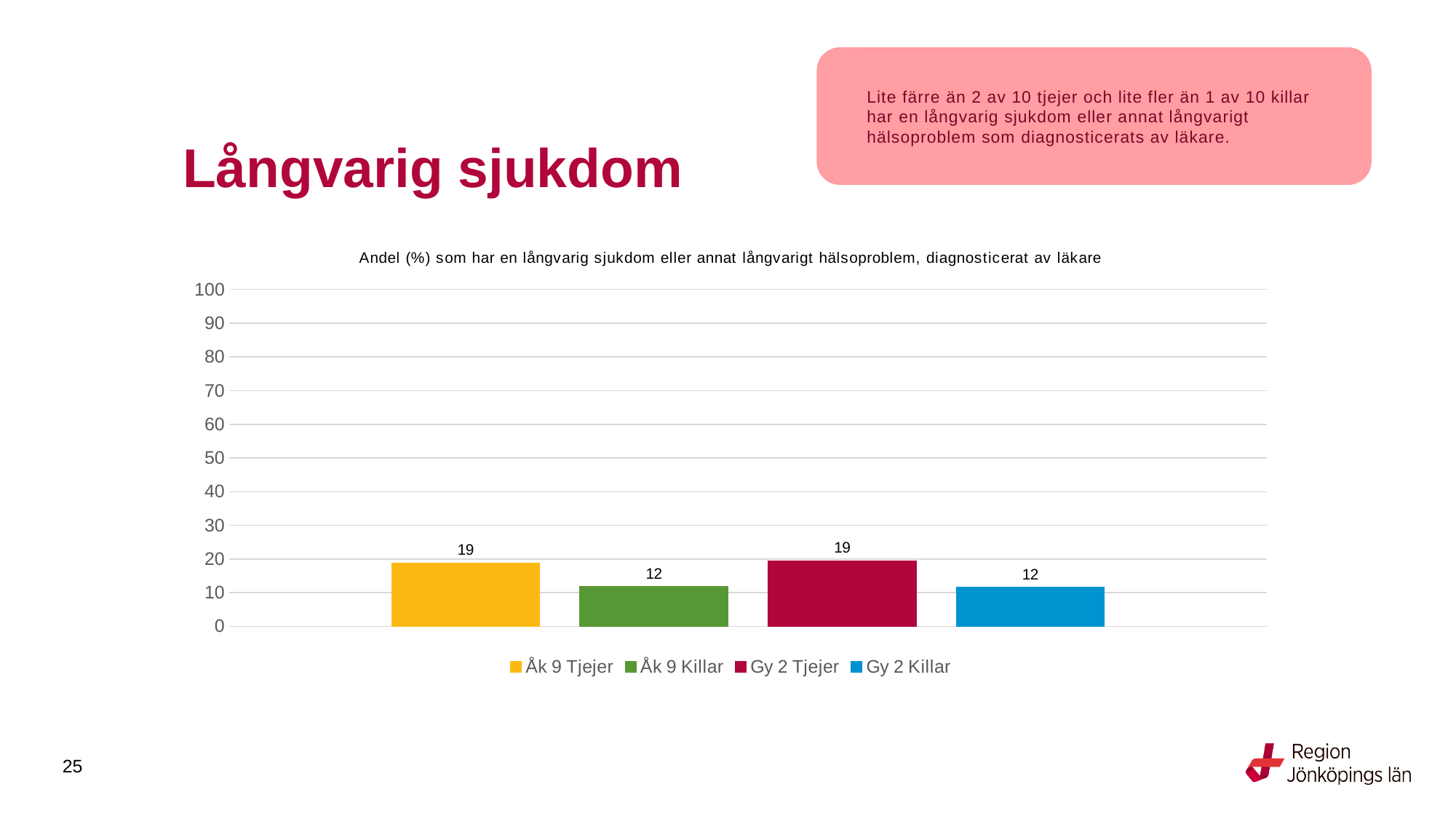
What is the value for Gy 2 Tjejer? 19 Which is larger, the value for Gy 2 Killar or the value for Gy 2 Tjejer? Gy 2 Tjejer Is the value for Åk 9 Killar greater or less than 20? less What is the difference between the value for Gy 2 Tjejer and the value for Gy 2 Killar? 7 How many series does the legend list? 4 What is the value for Gy 2 Killar? 12 How many bars are plotted in the chart? 4 What kind of chart is shown on the slide? bar chart What is the value for Åk 9 Killar? 12 What colour is the bar for Gy 2 Killar? blue What is the value for Åk 9 Tjejer? 19 Which is larger, the value for Åk 9 Tjejer or the value for Åk 9 Killar? Åk 9 Tjejer